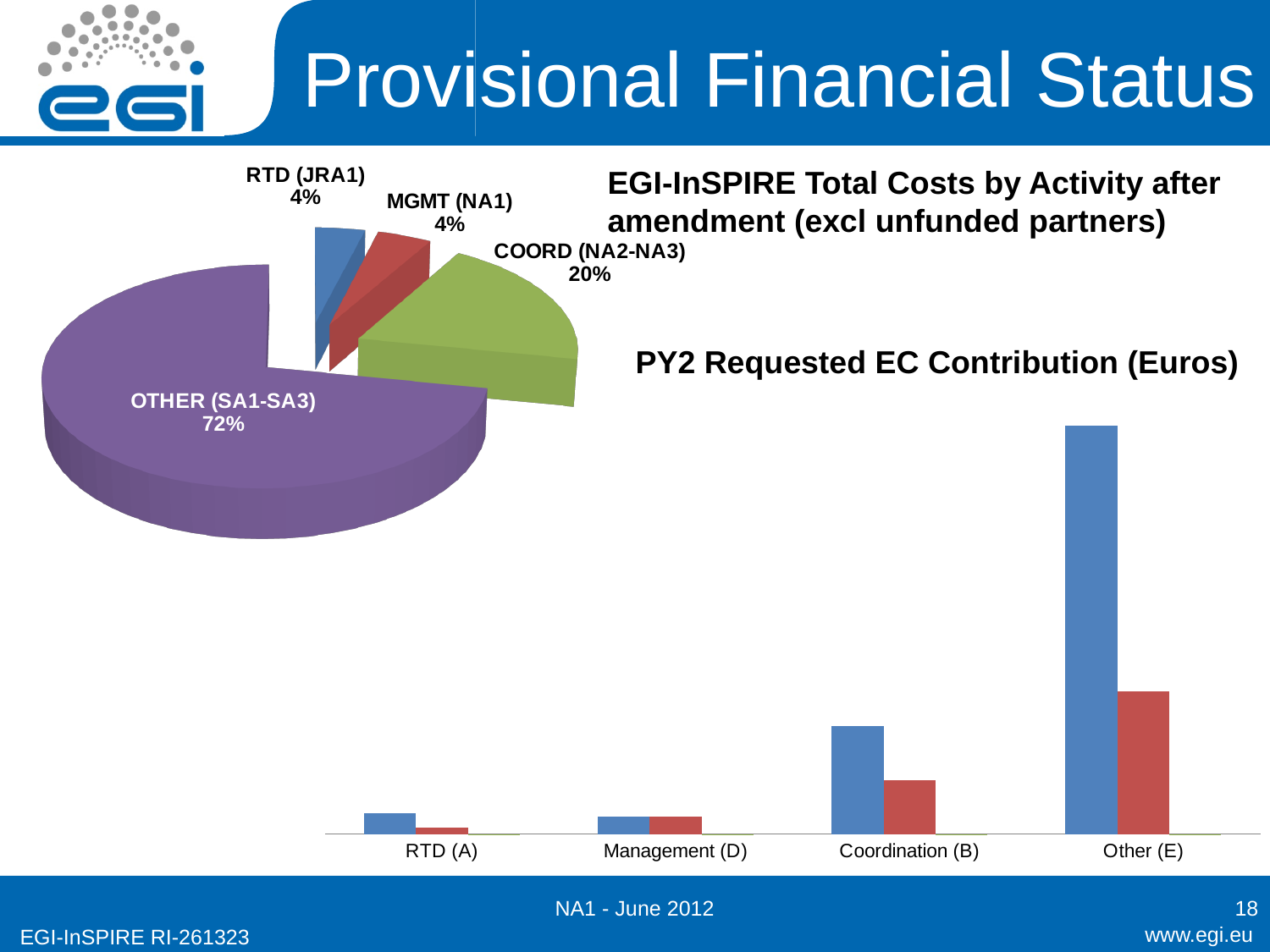
In the pie chart titled 'EGI-InSPIRE Total Costs by Activity after amendment (excl unfunded partners)', what share does RTD (JRA1) have? 4% In the pie chart titled 'EGI-InSPIRE Total Costs by Activity after amendment (excl unfunded partners)', what share does COORD (NA2-NA3) have? 20% In the chart titled 'PY2 Requested EC Contribution (Euros)', how many categories are shown on the x axis? 4 What kind of chart is the chart on the left of the slide? Pie chart In the chart titled 'PY2 Requested EC Contribution (Euros)', which has the taller blue bar, Coordination (B) or Management (D)? Coordination (B) In the pie chart titled 'EGI-InSPIRE Total Costs by Activity after amendment (excl unfunded partners)', what is the difference in percentage points between OTHER (SA1-SA3) and COORD (NA2-NA3)? 52 percentage points In the pie chart titled 'EGI-InSPIRE Total Costs by Activity after amendment (excl unfunded partners)', which is larger, the share of COORD (NA2-NA3) or the share of MGMT (NA1)? COORD (NA2-NA3) In the pie chart titled 'EGI-InSPIRE Total Costs by Activity after amendment (excl unfunded partners)', which activity has the largest share? OTHER (SA1-SA3) In the pie chart titled 'EGI-InSPIRE Total Costs by Activity after amendment (excl unfunded partners)', what share does OTHER (SA1-SA3) have? 72% What kind of chart is the chart titled 'PY2 Requested EC Contribution (Euros)'? Bar chart In the chart titled 'PY2 Requested EC Contribution (Euros)', which category has the tallest bar? Other (E) In the pie chart titled 'EGI-InSPIRE Total Costs by Activity after amendment (excl unfunded partners)', how many slices are there? 4